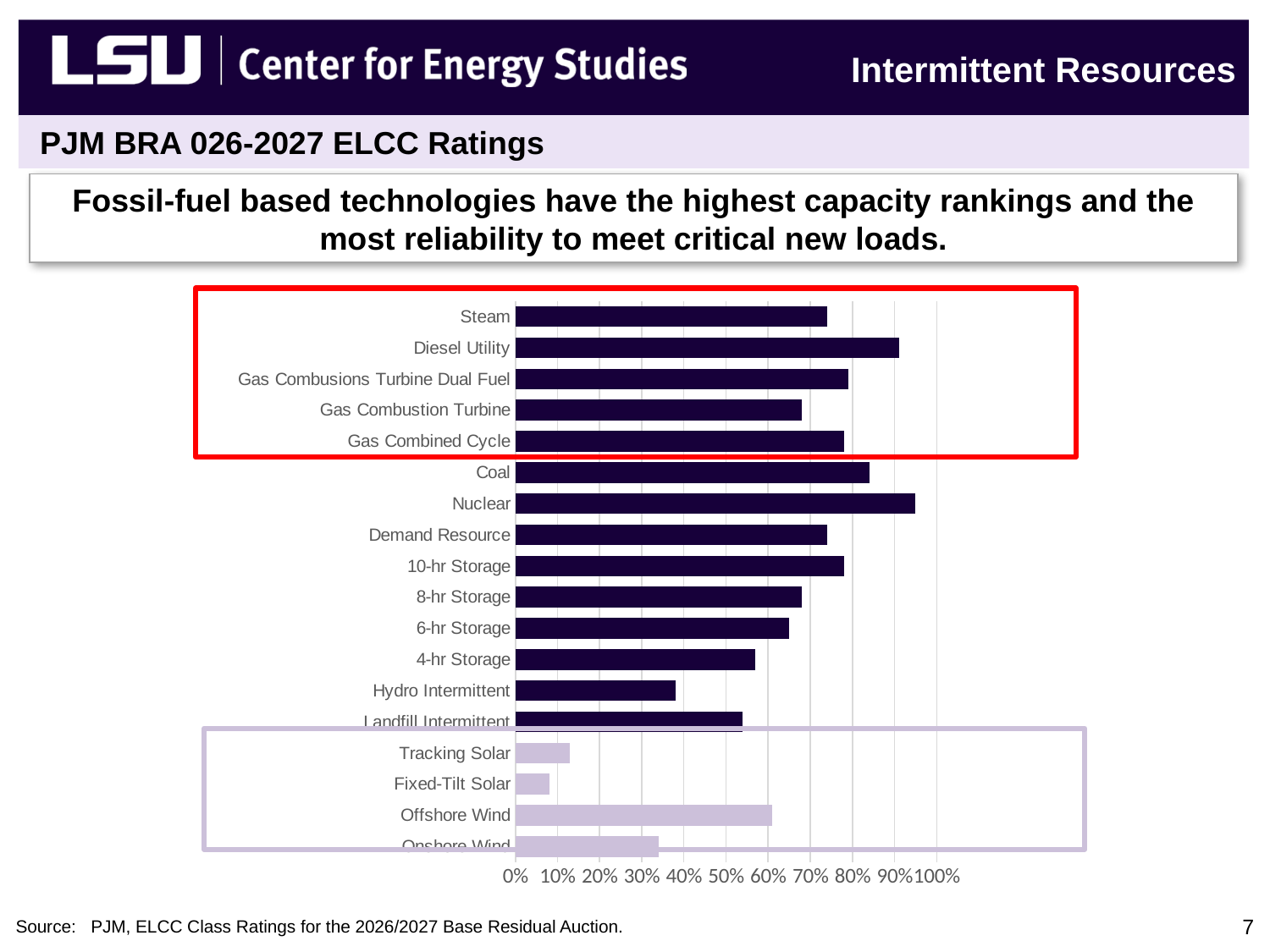
What kind of chart is shown on the slide? bar chart What is the title of the chart on the slide? PJM BRA 026-2027 ELCC Ratings Is the value for Nuclear greater or less than 90%? greater Is the value for Coal greater or less than 80%? greater Is the value for Hydro Intermittent greater or less than 40%? less Which category has the lowest ELCC rating in the chart? Fixed-Tilt Solar Which has a higher ELCC rating, Coal or Steam? Coal Which category has the highest ELCC rating in the chart? Nuclear Which has a higher ELCC rating, Offshore Wind or Onshore Wind? Offshore Wind How many categories are plotted in the chart? 18